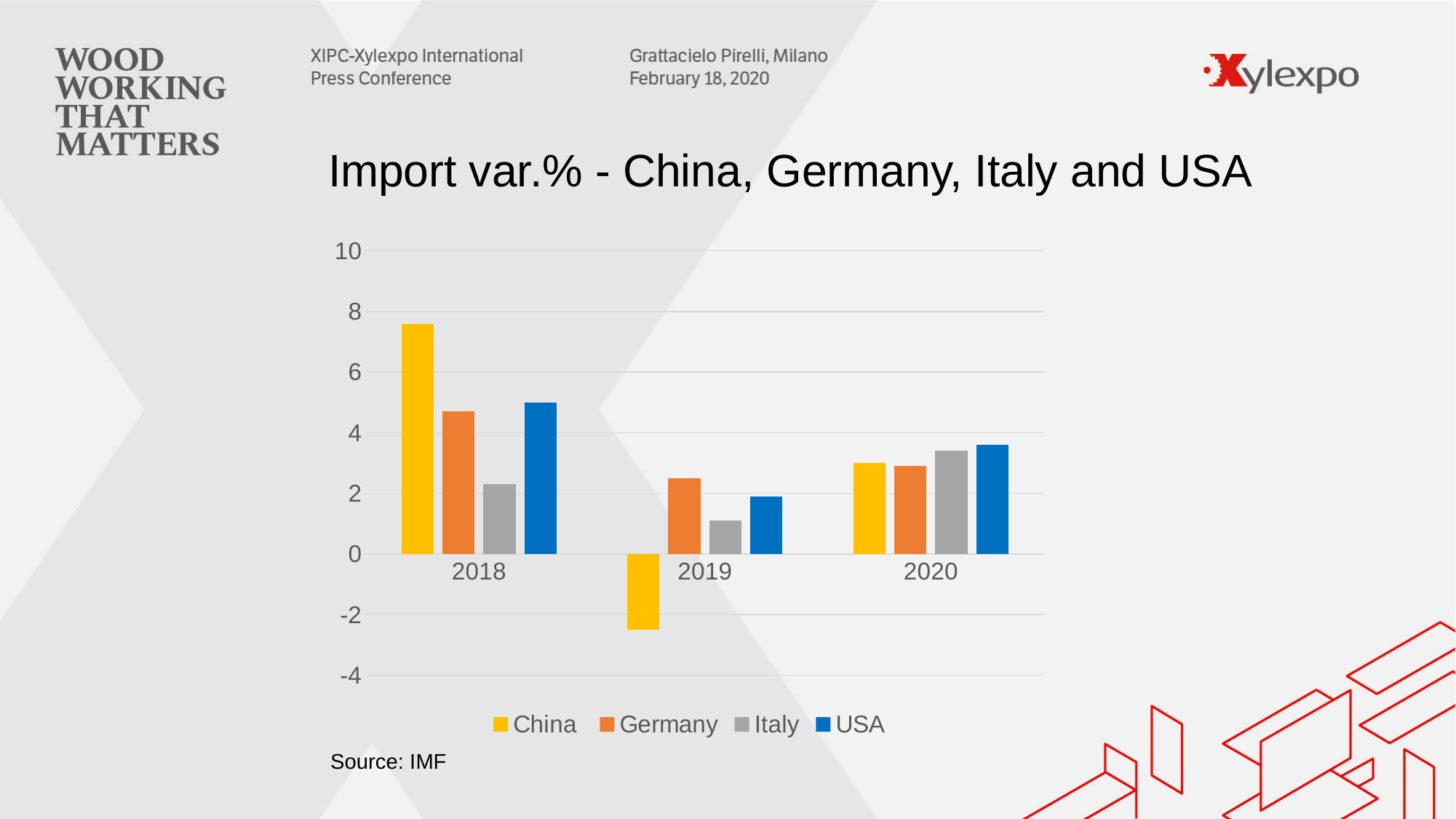
In 2019, which is larger: the value for Germany or the value for Italy? Germany What colour represents USA in the chart? blue Which country has the lowest import variation in 2018? Italy What kind of chart is shown on the slide? bar chart Is the value for Italy in 2018 greater or less than 4? less Does the value for China rise or fall from 2018 to 2019? fall Is the value for China in 2019 greater or less than 0? less Which country has the highest import variation in 2018? China Is the value for China in 2018 greater or less than 6? greater Which country has the lowest import variation in 2019? China How many series does the legend list? 4 How many years are shown on the x axis? 3